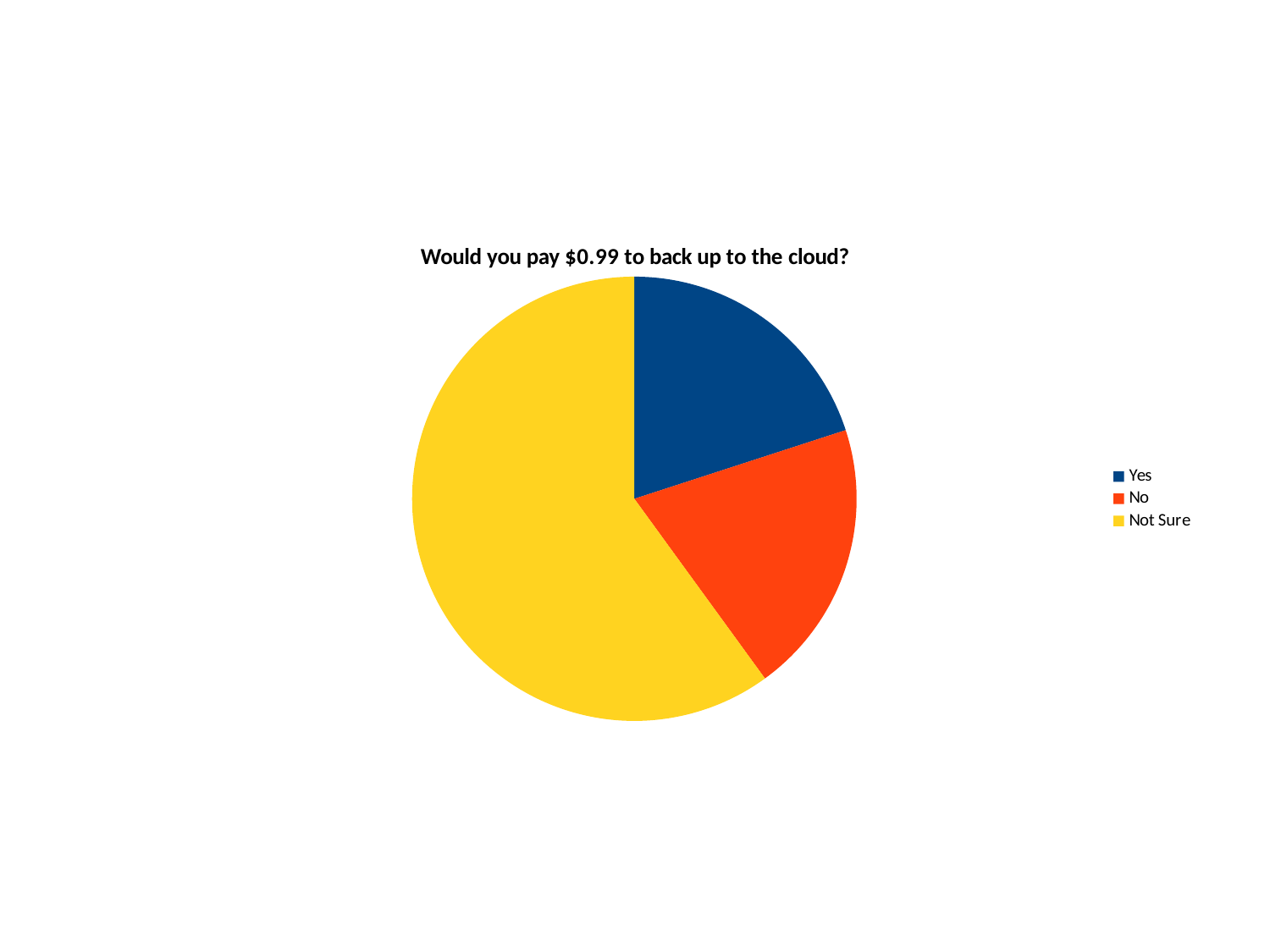
Which slice is larger, Not Sure or Yes? Not Sure How many slices does the pie chart have? 3 How many entries does the legend list? 3 Which response has the largest slice of the pie? Not Sure Is the Not Sure slice more or less than half of the pie? more Which slice is larger, Not Sure or No? Not Sure What is the title of the chart? Would you pay $0.99 to back up to the cloud? What colour is the Not Sure slice? yellow What kind of chart is shown on the slide? pie chart